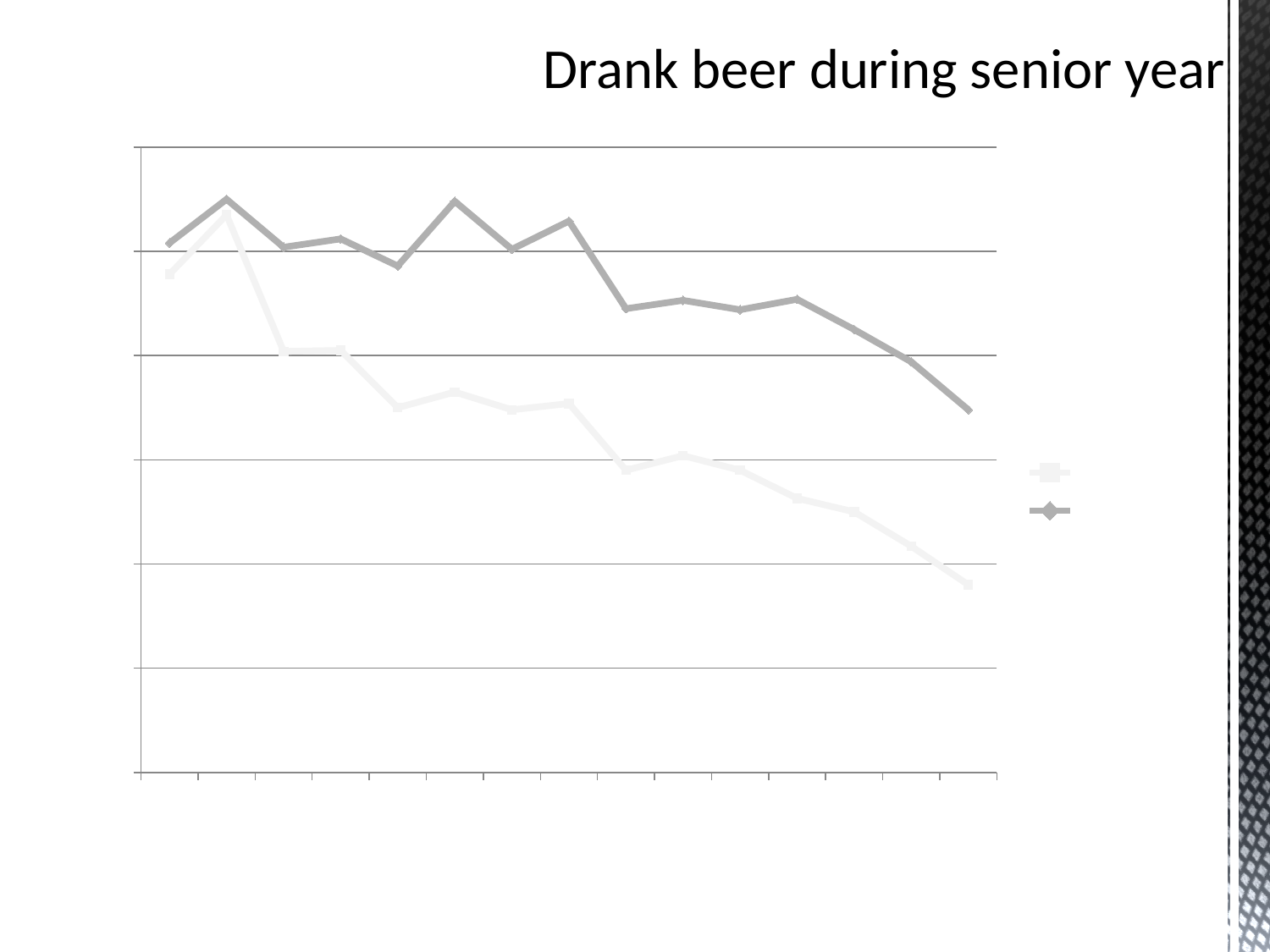
Which line is higher at the rightmost point, the darker line or the lighter line? the darker line How many series does the legend list? 2 Do the values of the darker line generally rise or fall from left to right? fall Do the values of the lighter line generally rise or fall from left to right? fall What is the title of the chart? Drank beer during senior year How many data points does each line have? 15 Which line is higher at the leftmost point, the darker line or the lighter line? the darker line What kind of chart is shown on the slide? line chart